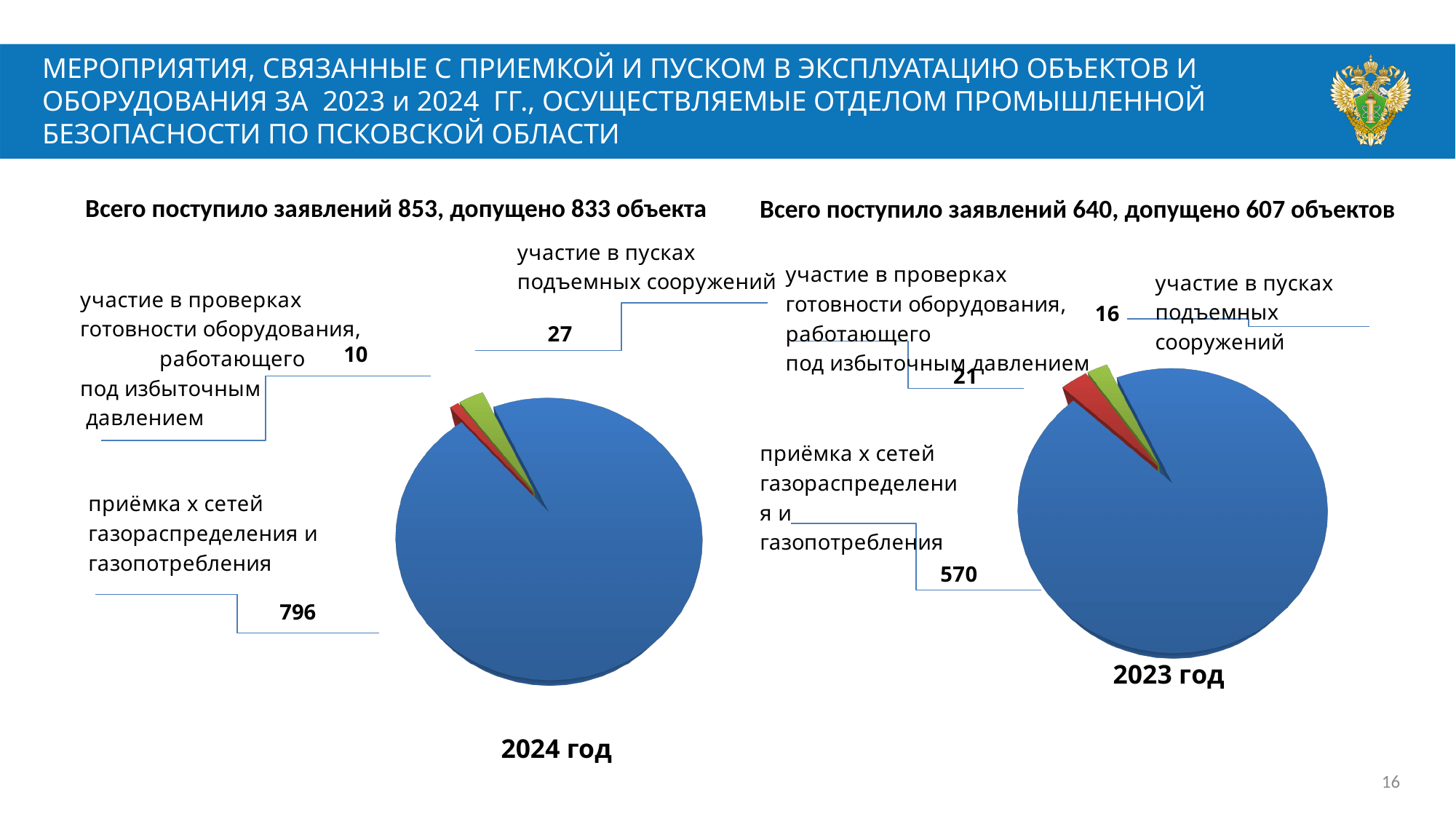
On the 2024 год pie chart, which category has the smallest value? участие в проверках готовности оборудования, работающего под избыточным давлением On the 2024 год pie chart, what colour is the slice for приёмка сетей газораспределения и газопотребления? blue On the 2023 год pie chart, which category has the largest value? приёмка сетей газораспределения и газопотребления How many categories does the 2023 год pie chart show? 3 On the 2024 год pie chart, what is the value for приёмка сетей газораспределения и газопотребления? 796 On the 2023 год pie chart, what is the value for участие в проверках готовности оборудования, работающего под избыточным давлением? 21 What is the total of all slices on the 2023 год pie chart? 607 On the 2024 год pie chart, what is the value for участие в пусках подъемных сооружений? 27 What type of chart is used for the 2024 год data? pie chart On the 2023 год pie chart, what is the value for участие в пусках подъемных сооружений? 16 What is the difference between the value for приёмка сетей газораспределения и газопотребления on the 2024 год chart and on the 2023 год chart? 226 Which is larger: участие в пусках подъемных сооружений on the 2024 год chart or on the 2023 год chart? 2024 год